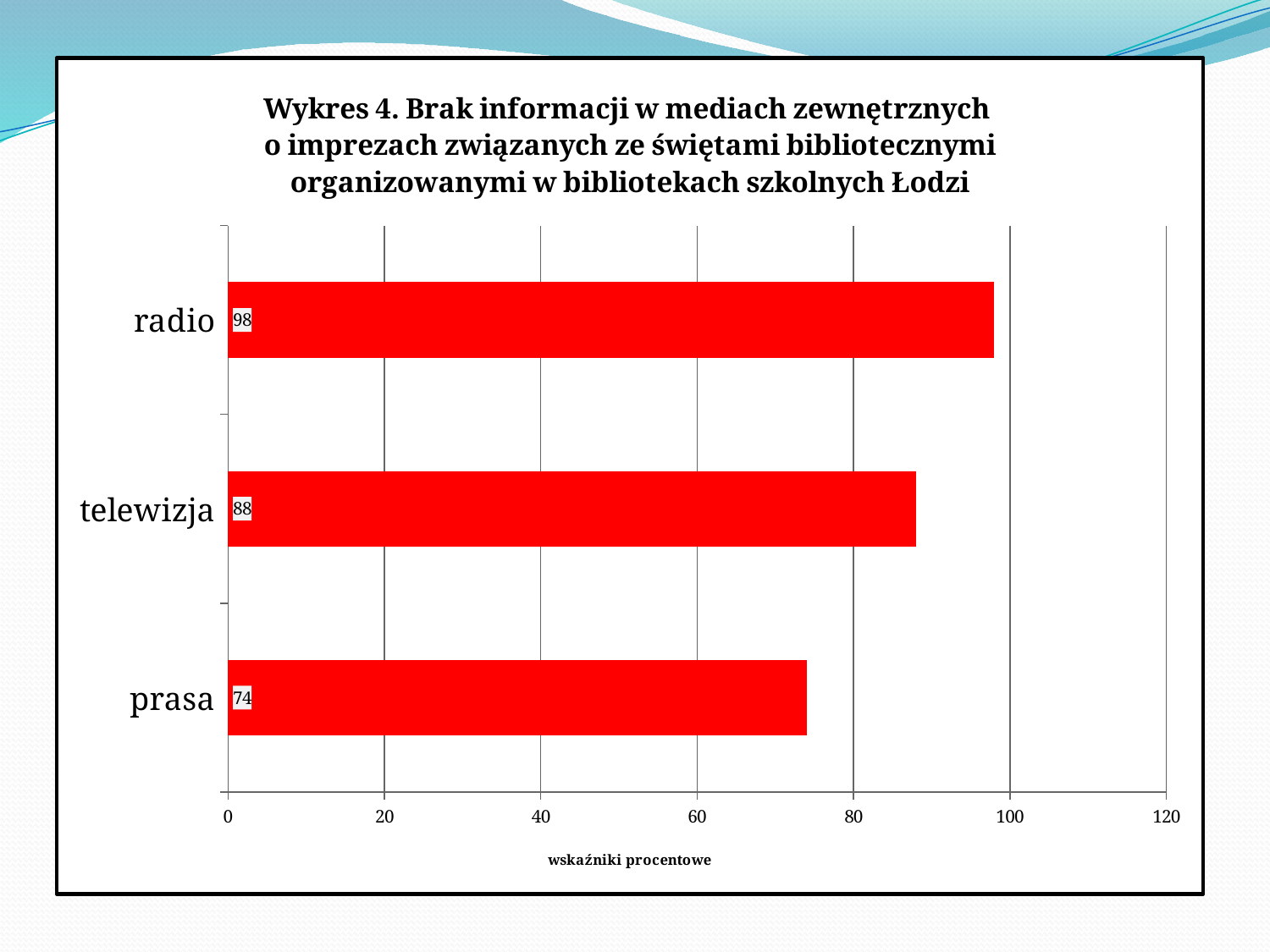
How many categories are shown in the chart? 3 Which category has the lowest value? prasa Which is larger, the value for telewizja or the value for prasa? telewizja What is the value for radio? 98 Is the value for telewizja greater or less than 80? greater What is the difference between the values for radio and prasa? 24 Which category has the highest value? radio What kind of chart is shown on the slide? bar chart What is the label of the horizontal axis? wskaźniki procentowe What is the value for telewizja? 88 What is the difference between the values for telewizja and prasa? 14 What is the value for prasa? 74